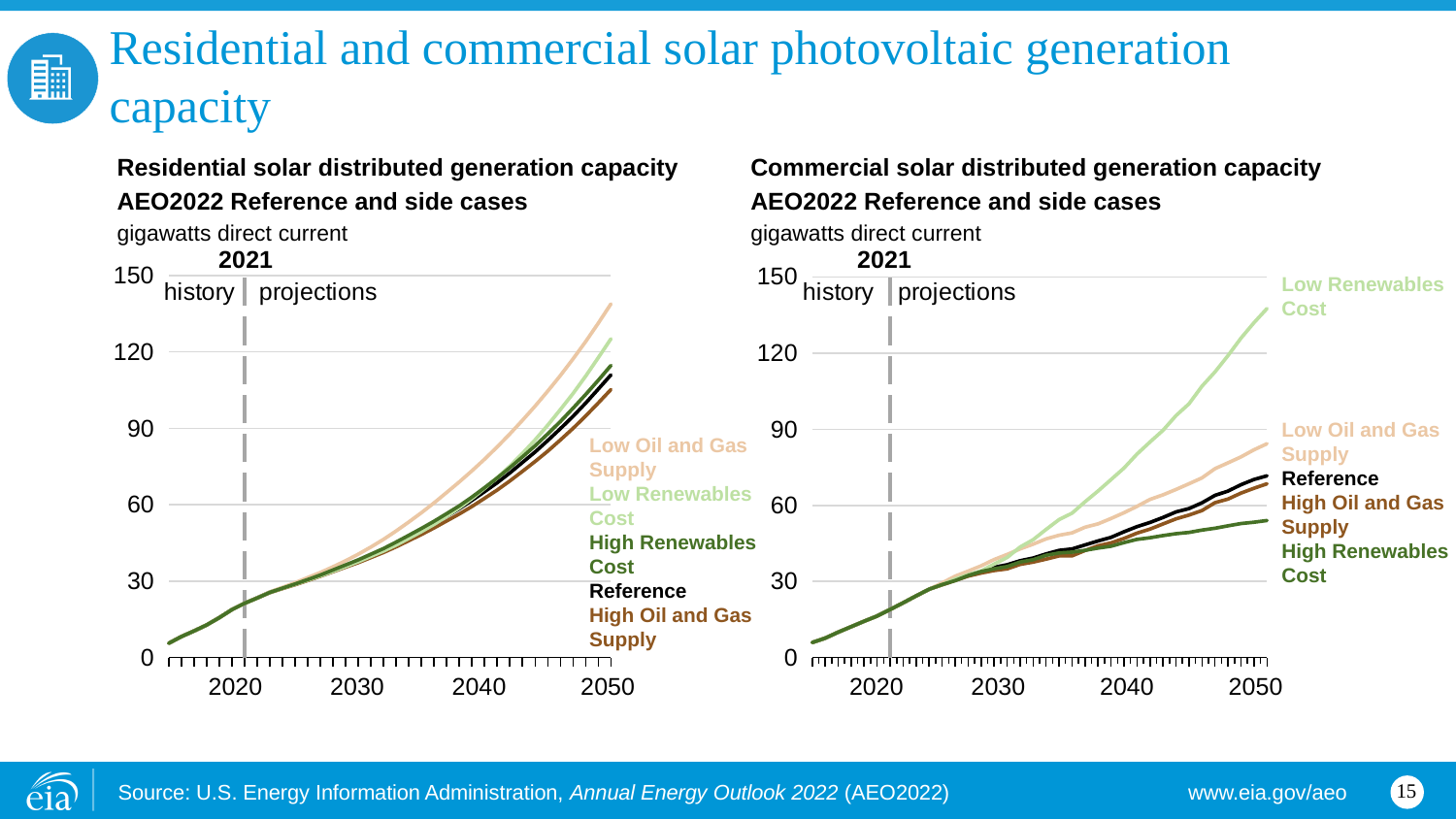
In the Residential solar distributed generation capacity chart, which case has the lowest value in 2050? High Oil and Gas Supply In the Commercial solar distributed generation capacity chart, which case has the lowest value in 2050? High Renewables Cost What type of chart is the Residential solar distributed generation capacity chart? line chart How many series are labelled on the Commercial solar distributed generation capacity chart? 5 In the Residential solar distributed generation capacity chart, is the 2050 value for Low Oil and Gas Supply greater or less than 120? greater In the Residential solar distributed generation capacity chart, do the values rise or fall from 2020 to 2050? rise In the Commercial solar distributed generation capacity chart, is the 2050 value for Low Renewables Cost greater or less than 120? greater In the Residential solar distributed generation capacity chart, which case has the highest value in 2050? Low Oil and Gas Supply In the Commercial solar distributed generation capacity chart, which is larger in 2050: Low Oil and Gas Supply or Reference? Low Oil and Gas Supply In the Commercial solar distributed generation capacity chart, which case has the highest value in 2050? Low Renewables Cost What unit is used on the y axis of the Commercial solar distributed generation capacity chart? gigawatts direct current In the Commercial solar distributed generation capacity chart, is the 2050 value for High Renewables Cost greater or less than 60? less